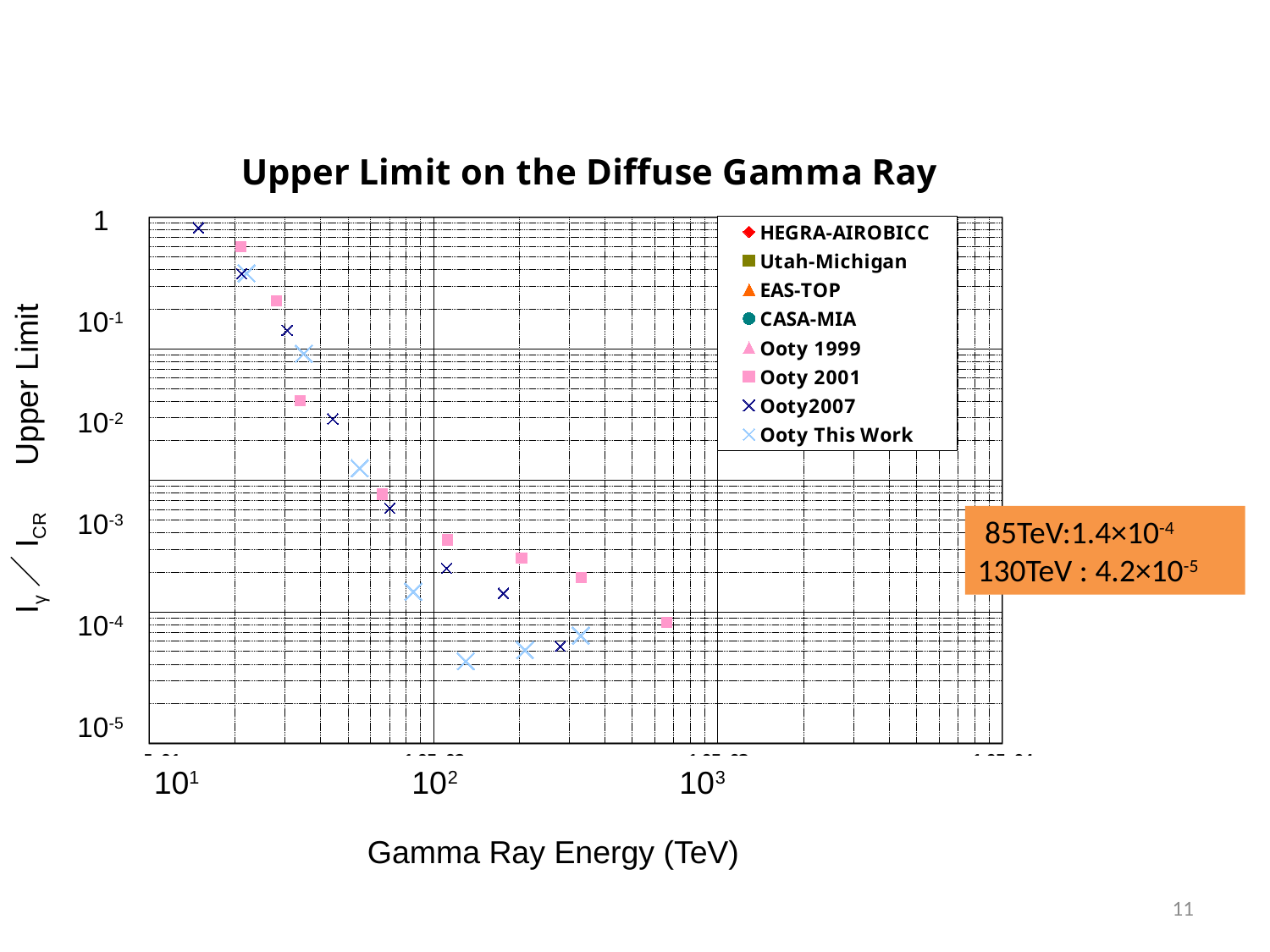
What kind of chart is shown on the slide? scatter chart Which series contains the lowest plotted point on the chart? Ooty This Work At around 130 TeV, which series has the larger upper limit, Ooty 2001 or Ooty This Work? Ooty 2001 Do the plotted upper limits generally rise or fall as gamma ray energy increases along the x axis? fall Is the Ooty2007 value at about 10 TeV greater or less than 10^-1? greater What is the title of the chart? Upper Limit on the Diffuse Gamma Ray Is the Ooty This Work value at about 130 TeV greater or less than 10^-4? less According to the annotation box, what is the upper limit at 130 TeV? 4.2×10^-5 How many series does the legend list? 8 According to the annotation box, what is the upper limit at 85 TeV? 1.4×10^-4 Is the Ooty This Work value at about 50 TeV greater or less than 10^-2? less Which series is plotted with light blue X markers? Ooty This Work